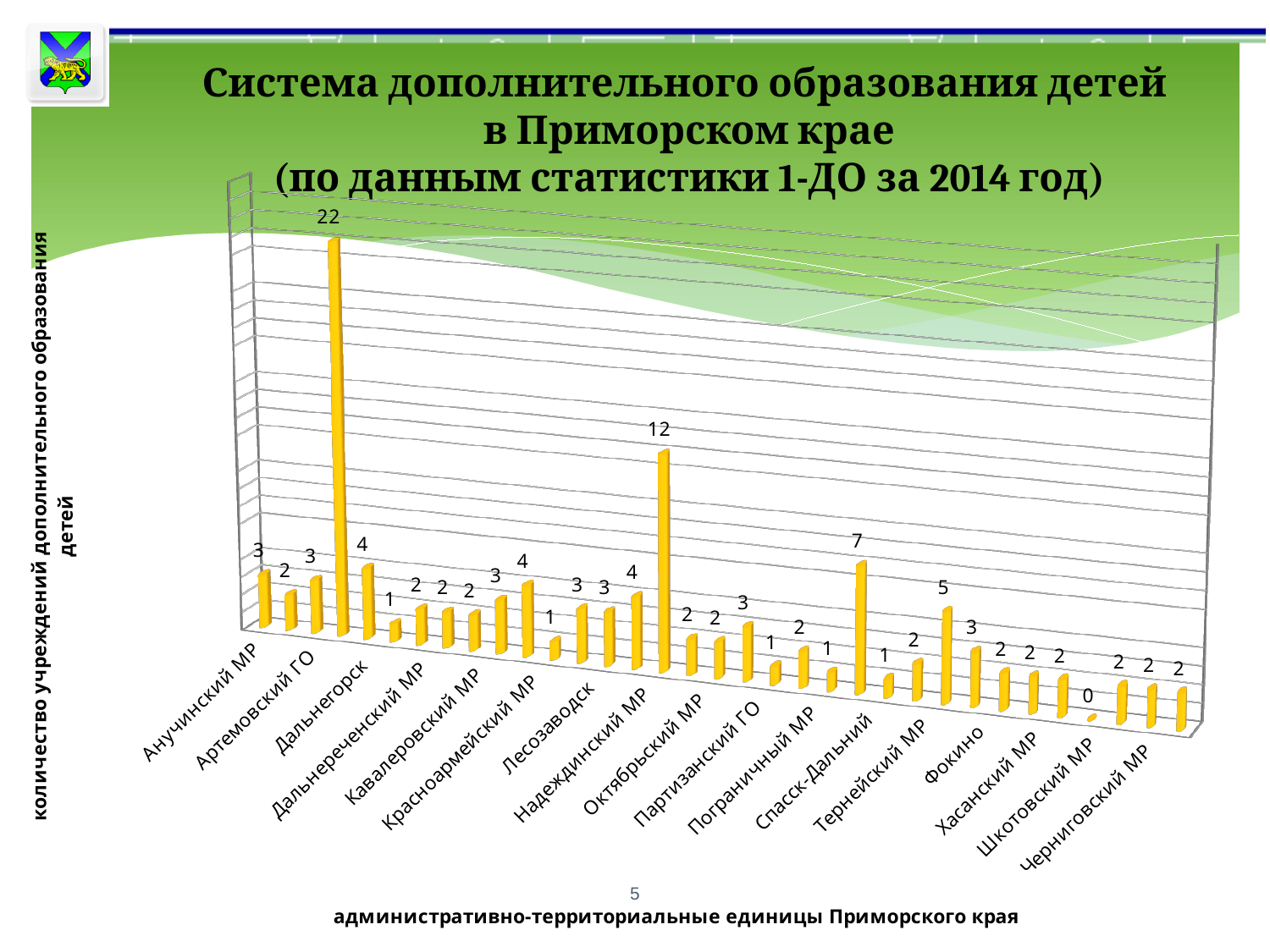
What is the label of the x axis? административно-территориальные единицы Приморского края What is the label of the y axis? количество учреждений дополнительного образования детей Which has a larger value, Спасск-Дальний or Анучинский МР? Спасск-Дальний What is the difference between the highest value (22) and the second highest value (12)? 10 What is the value for Спасск-Дальний? 7 What is the value for Шкотовский МР? 0 What is the highest value shown on the chart? 22 How many bars are plotted on the chart? 34 What type of chart is shown on the slide? bar chart What is the second highest value shown on the chart? 12 What is the lowest value shown on the chart? 0 What is the value for Анучинский МР? 3